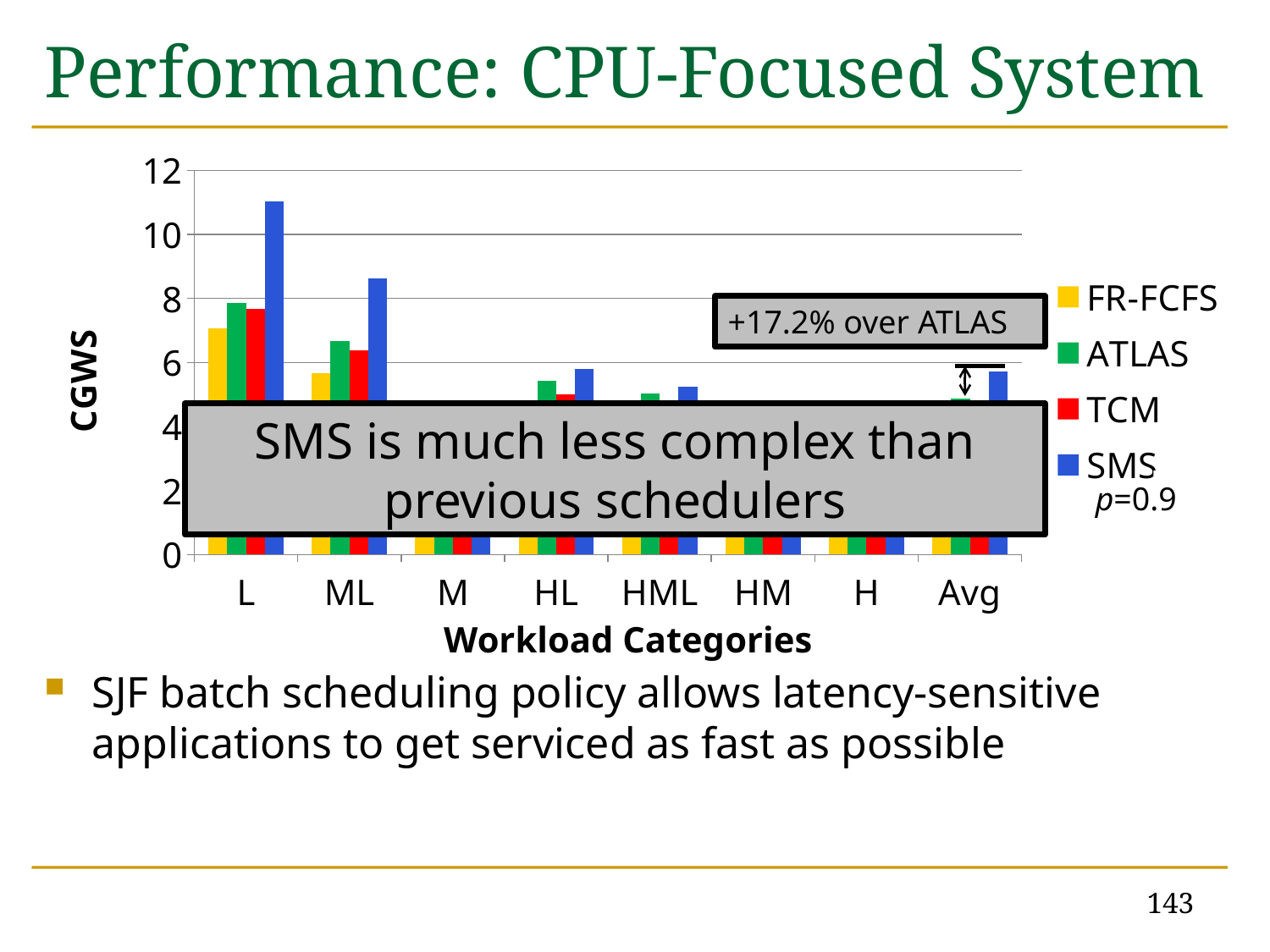
How many series does the legend list? 4 Is the SMS value for workload category L greater or less than 10? greater Is the ATLAS value for workload category HL greater or less than 6? less Is the SMS value for workload category ML greater or less than 8? greater Which is larger: the SMS value for L or the SMS value for ML? L According to the annotation on the chart, by what percentage does SMS improve over ATLAS on average? +17.2% What kind of chart is shown on the slide? bar chart For which workload category is the SMS bar the highest? L Which is larger for workload category L: the FR-FCFS value or the ATLAS value? ATLAS How many workload categories are shown on the x axis? 8